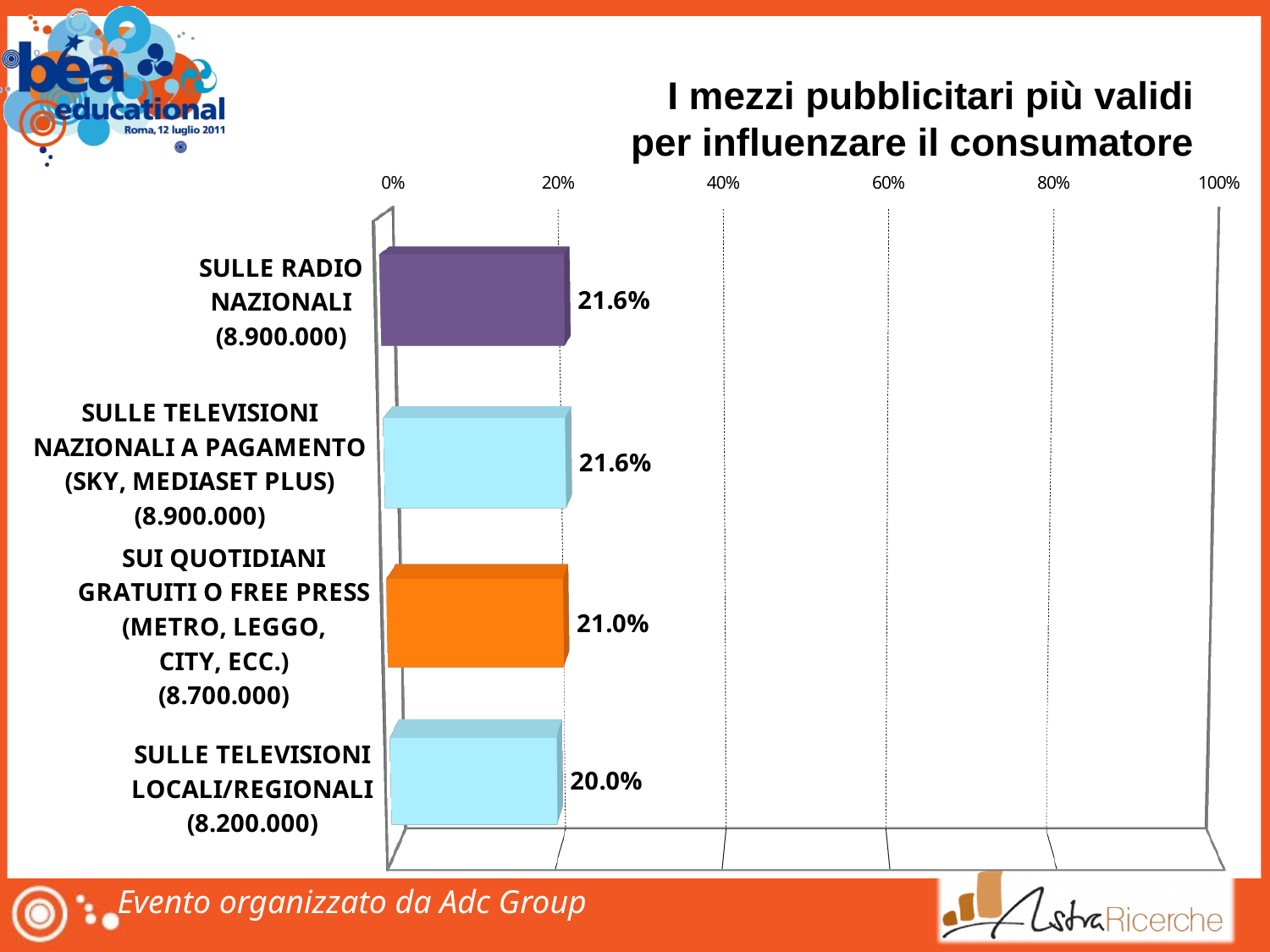
What is the difference between the value for SULLE RADIO NAZIONALI and the value for SULLE TELEVISIONI LOCALI/REGIONALI? 1.6 percentage points Which is larger, the value for SUI QUOTIDIANI GRATUITI O FREE PRESS or the value for SULLE TELEVISIONI LOCALI/REGIONALI? SUI QUOTIDIANI GRATUITI O FREE PRESS Which category has the lowest value? SULLE TELEVISIONI LOCALI/REGIONALI What is the difference between the value for SULLE TELEVISIONI NAZIONALI A PAGAMENTO and the value for SUI QUOTIDIANI GRATUITI O FREE PRESS? 0.6 percentage points What is the value for SULLE TELEVISIONI LOCALI/REGIONALI? 20.0% How many categories are shown in the chart? 4 What kind of chart is shown on the slide? bar chart What is the value for SUI QUOTIDIANI GRATUITI O FREE PRESS (METRO, LEGGO, CITY, ECC.)? 21.0% What is the title of the chart? I mezzi pubblicitari più validi per influenzare il consumatore What is the value for SULLE RADIO NAZIONALI? 21.6% What is the value for SULLE TELEVISIONI NAZIONALI A PAGAMENTO (SKY, MEDIASET PLUS)? 21.6% Is the value for SULLE RADIO NAZIONALI greater or less than 40%? less